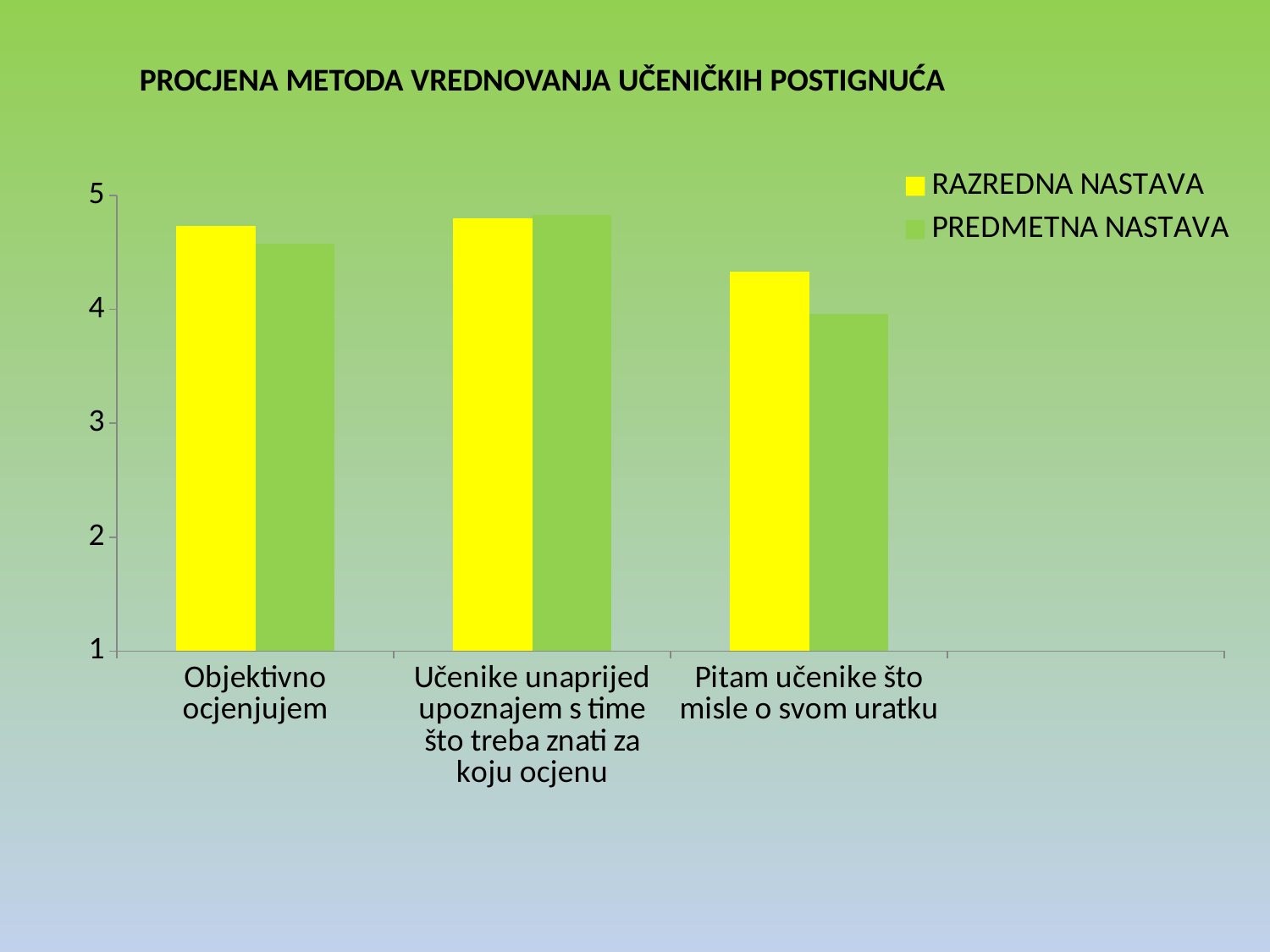
Which series is shown in yellow? RAZREDNA NASTAVA How many series does the legend list? 2 Is the RAZREDNA NASTAVA value for 'Pitam učenike što misle o svom uratku' greater or less than 4? greater For 'Pitam učenike što misle o svom uratku', which series has the larger value, RAZREDNA NASTAVA or PREDMETNA NASTAVA? RAZREDNA NASTAVA Is the RAZREDNA NASTAVA value for 'Objektivno ocjenjujem' greater or less than 5? less For 'Objektivno ocjenjujem', which series has the larger value, RAZREDNA NASTAVA or PREDMETNA NASTAVA? RAZREDNA NASTAVA Which category has the highest PREDMETNA NASTAVA value? Učenike unaprijed upoznajem s time što treba znati za koju ocjenu How many categories are shown on the x axis? 3 What kind of chart is shown on the slide? bar chart Is the PREDMETNA NASTAVA value for 'Objektivno ocjenjujem' greater or less than 4? greater What is the title of the chart? PROCJENA METODA VREDNOVANJA UČENIČKIH POSTIGNUĆA Which category has the lowest PREDMETNA NASTAVA value? Pitam učenike što misle o svom uratku